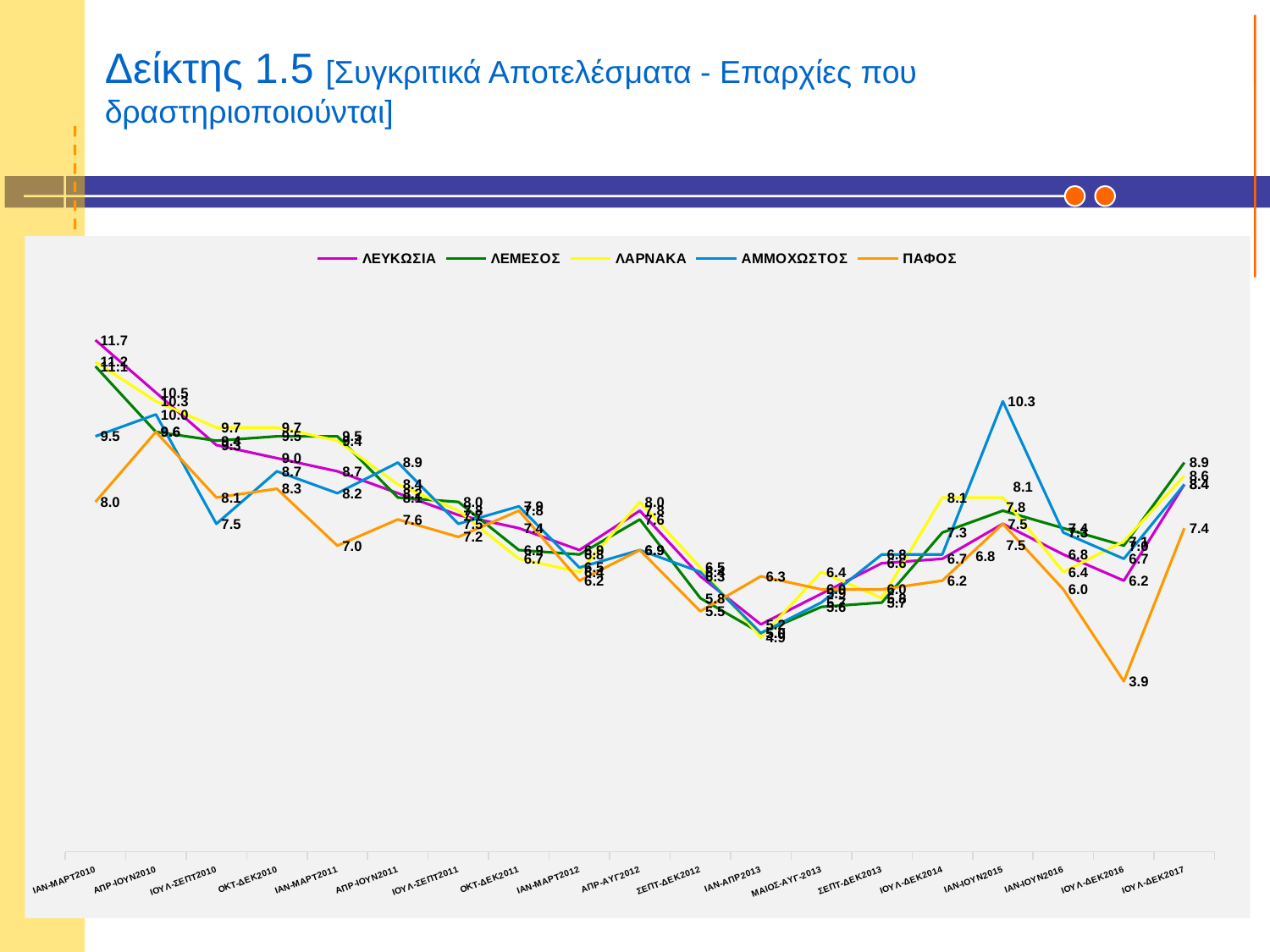
What is the value for ΛΕΥΚΩΣΙΑ in ΙΑΝ-ΜΑΡΤ2010? 11.7 What is the value for ΠΑΦΟΣ in ΙΟΥΛ-ΔΕΚ2017? 7.4 Which series has the highest value in ΙΑΝ-ΙΟΥΝ2015? ΑΜΜΟΧΩΣΤΟΣ How many time periods are shown along the x axis? 19 What kind of chart is shown on the slide? line chart Does the ΠΑΦΟΣ line rise or fall from ΙΟΥΛ-ΔΕΚ2016 to ΙΟΥΛ-ΔΕΚ2017? rise In ΙΑΝ-ΜΑΡΤ2010, which is larger: the value for ΛΕΥΚΩΣΙΑ or the value for ΠΑΦΟΣ? ΛΕΥΚΩΣΙΑ What is the value for ΑΜΜΟΧΩΣΤΟΣ in ΙΑΝ-ΙΟΥΝ2015? 10.3 How many series does the legend list? 5 Which series has the lowest value in ΙΟΥΛ-ΔΕΚ2016? ΠΑΦΟΣ What is the difference between ΑΜΜΟΧΩΣΤΟΣ (10.3) and ΠΑΦΟΣ (7.5) in ΙΑΝ-ΙΟΥΝ2015? 2.8 What is the value for ΠΑΦΟΣ in ΙΟΥΛ-ΔΕΚ2016? 3.9